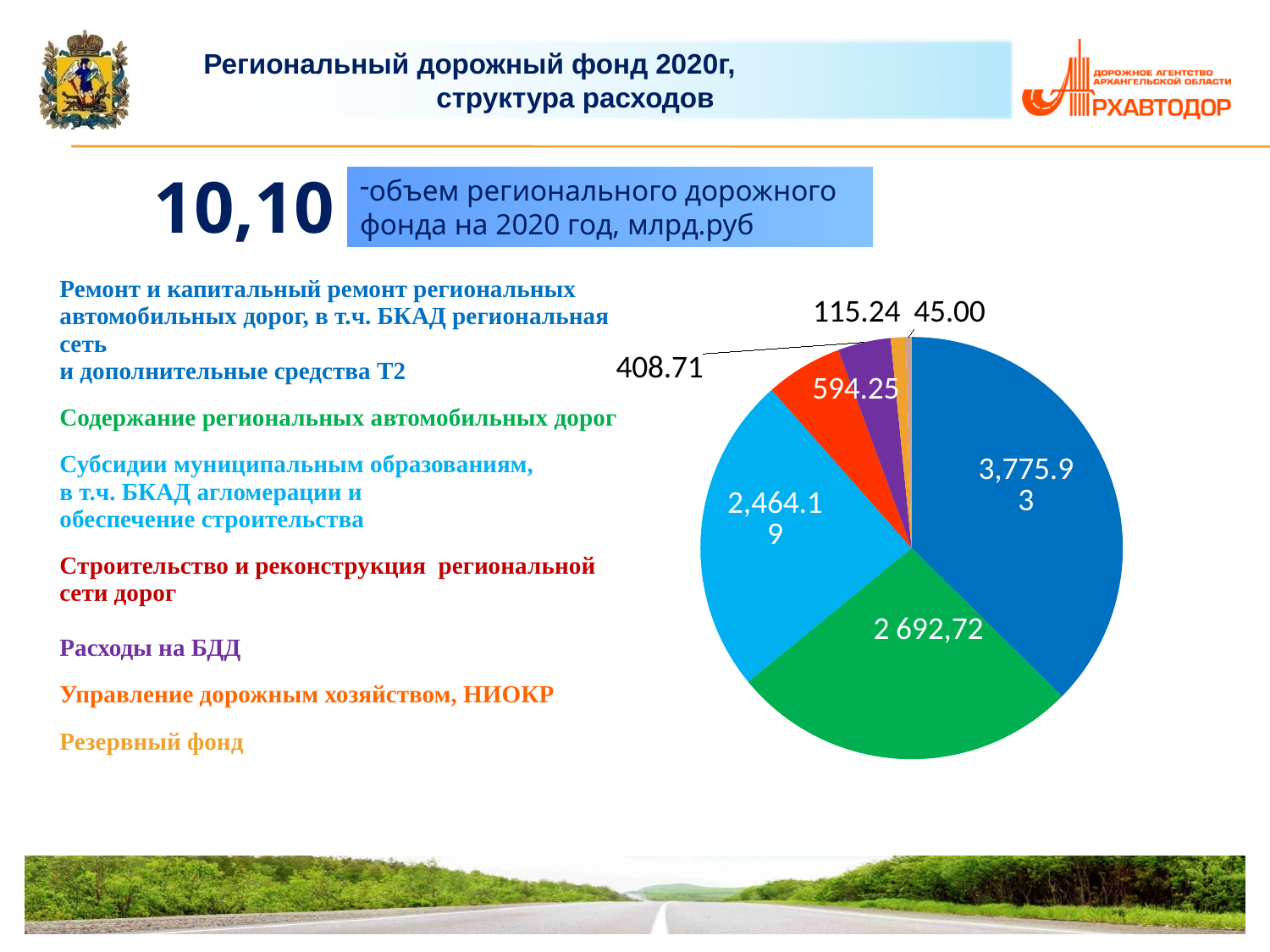
What value is shown for 'Субсидии муниципальным образованиям' (light blue slice)? 2,464.19 What is the value of the largest slice of the pie chart? 3,775.93 Which slice is larger: the green one (Содержание региональных автомобильных дорог) or the light blue one (Субсидии муниципальным образованиям)? Содержание региональных автомобильных дорог What value is shown for 'Содержание региональных автомобильных дорог' (green slice)? 2 692,72 What value is shown for 'Строительство и реконструкция региональной сети дорог' (red slice)? 594.25 What total volume of the regional road fund for 2020, in billion rubles, is stated on the slide? 10,10 What kind of chart is shown on the slide? pie chart How many slices does the pie chart have? 7 What value is shown for the slice 'Ремонт и капитальный ремонт региональных автомобильных дорог' (blue)? 3,775.93 What is the value of the smallest slice of the pie chart? 45.00 What is the difference between the red slice (594.25) and the purple slice (408.71)? 185.54 What value is shown for 'Расходы на БДД' (purple slice)? 408.71